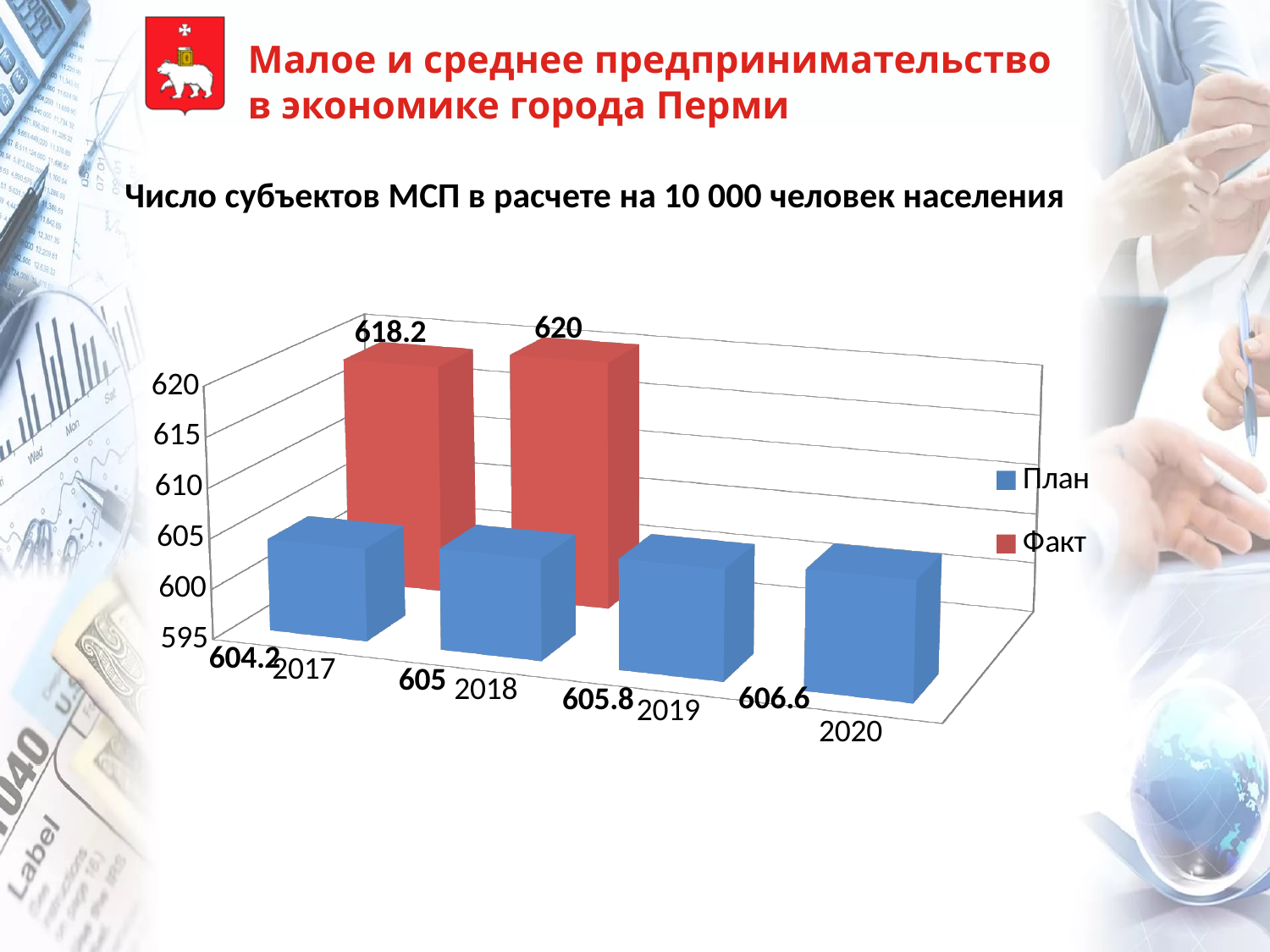
What is the План value for 2017? 604.2 Do the План values rise or fall from 2017 to 2020? Rise What is the difference between the Факт values for 2018 and 2017? 1.8 How many series does the legend list? 2 What is the Факт value for 2017? 618.2 What is the План value for 2020? 606.6 Which is larger for 2018, the План value or the Факт value? Факт Which year has the highest План value? 2020 Which year has the lowest План value? 2017 What is the difference between the Факт and План values for 2017? 14 What kind of chart is shown on the slide? Bar chart What is the Факт value for 2018? 620